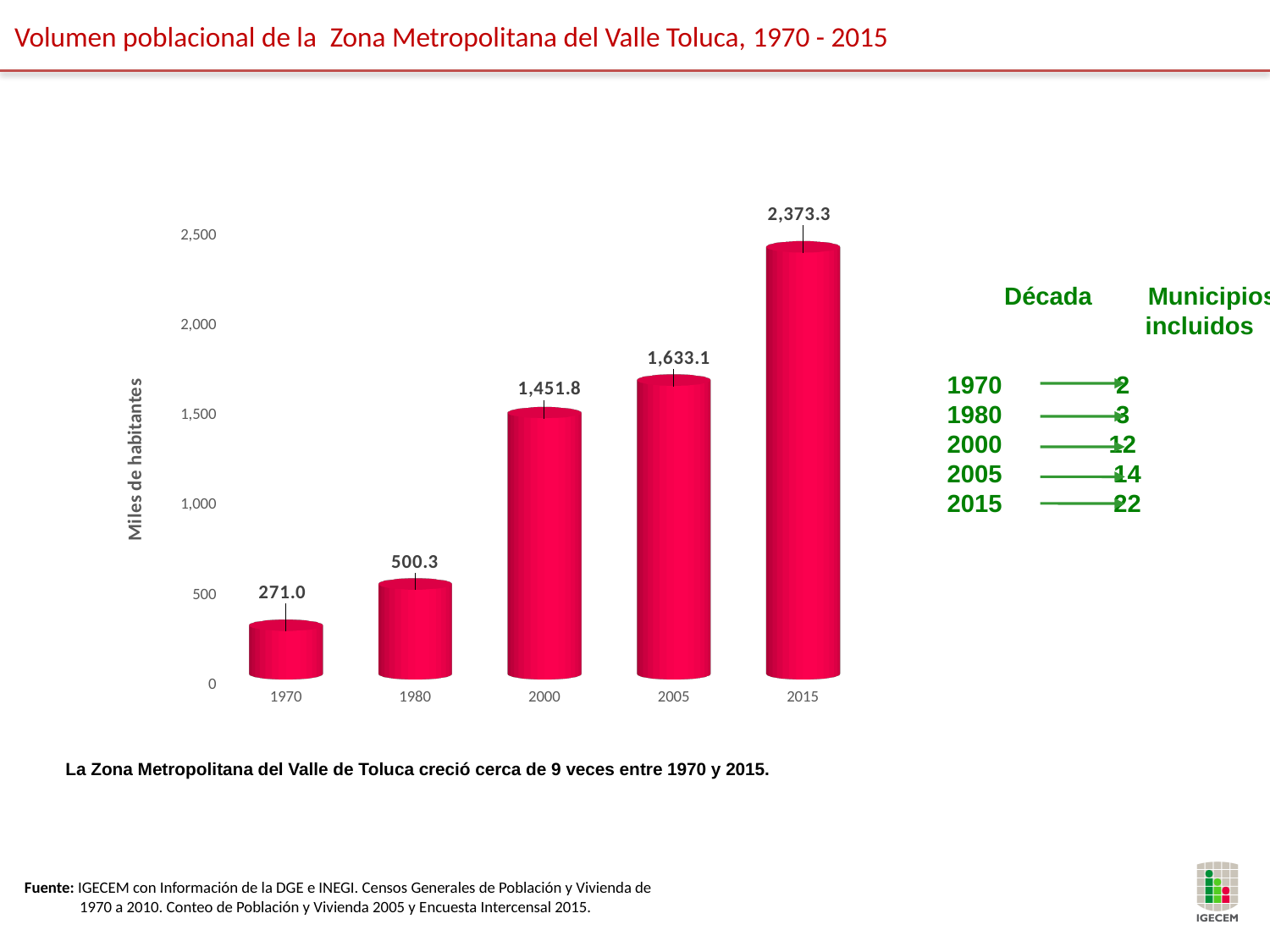
What is the value for 2015? 2,373.3 Which year has the lowest value? 1970 What is the difference between the values for 2005 and 2000? 181.3 Which year has the highest value? 2015 What is the value for 2000? 1,451.8 Do the values rise or fall from 1970 to 2015? rise Which is larger, the value for 1980 or the value for 2005? 2005 Is the value for 2015 greater or less than 2,000? greater What kind of chart is this? bar chart How many years are shown on the x axis? 5 What is the difference between the values for 1980 and 1970? 229.3 What is the value for 1970? 271.0